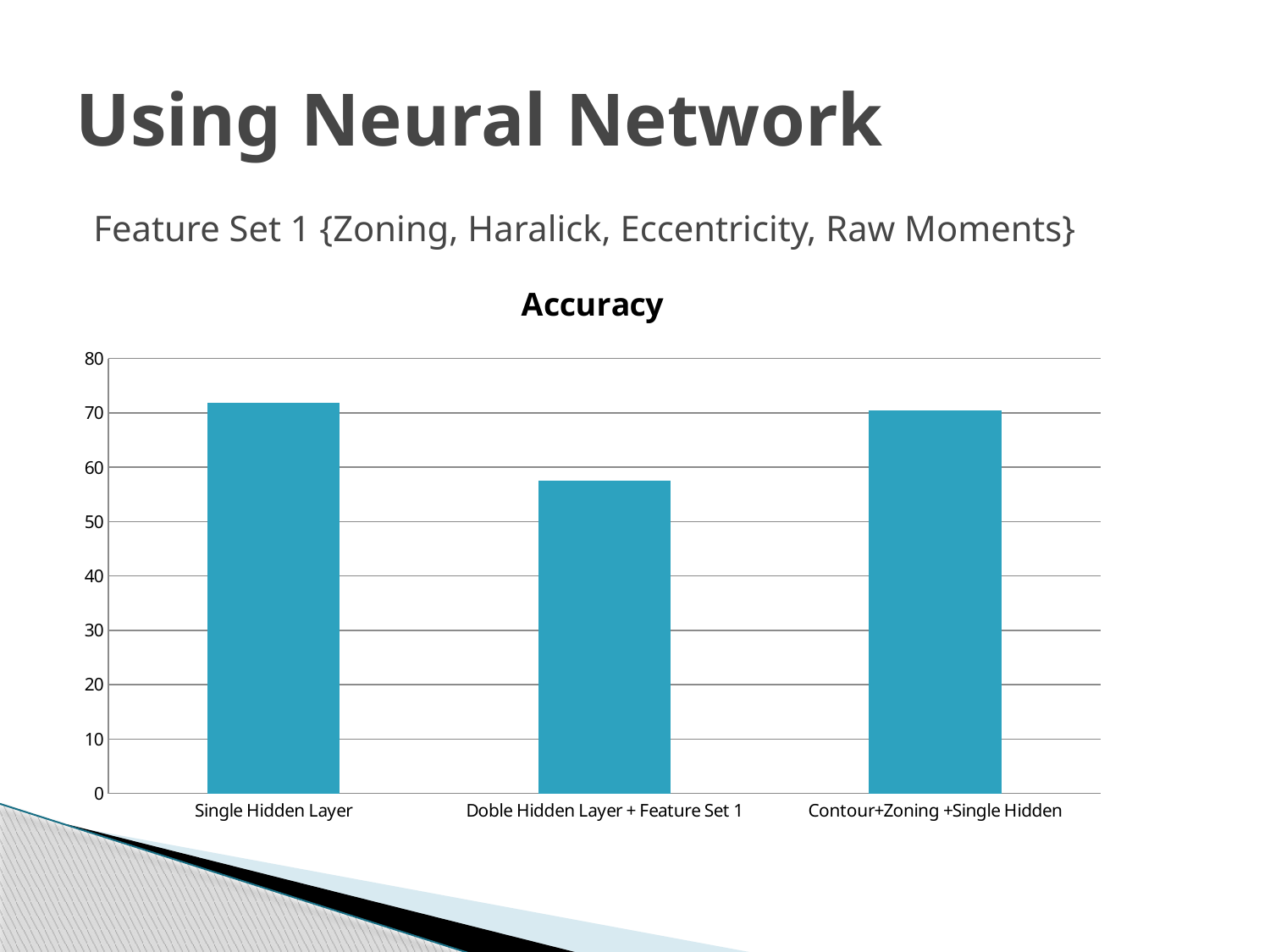
Which category has the lowest accuracy? Doble Hidden Layer + Feature Set 1 Which is larger, the value for Contour+Zoning +Single Hidden or the value for Doble Hidden Layer + Feature Set 1? Contour+Zoning +Single Hidden What kind of chart is shown on the slide? bar chart Is the value for Single Hidden Layer greater or less than 70? greater Which is larger, the value for Single Hidden Layer or the value for Doble Hidden Layer + Feature Set 1? Single Hidden Layer Is the value for Doble Hidden Layer + Feature Set 1 greater or less than 60? less Is the value for Doble Hidden Layer + Feature Set 1 greater or less than 50? greater What is the title of the chart? Accuracy What is the highest value shown on the y axis of the chart? 80 How many categories are plotted on the x axis of the chart? 3 Does the value rise or fall from Single Hidden Layer to Doble Hidden Layer + Feature Set 1? fall